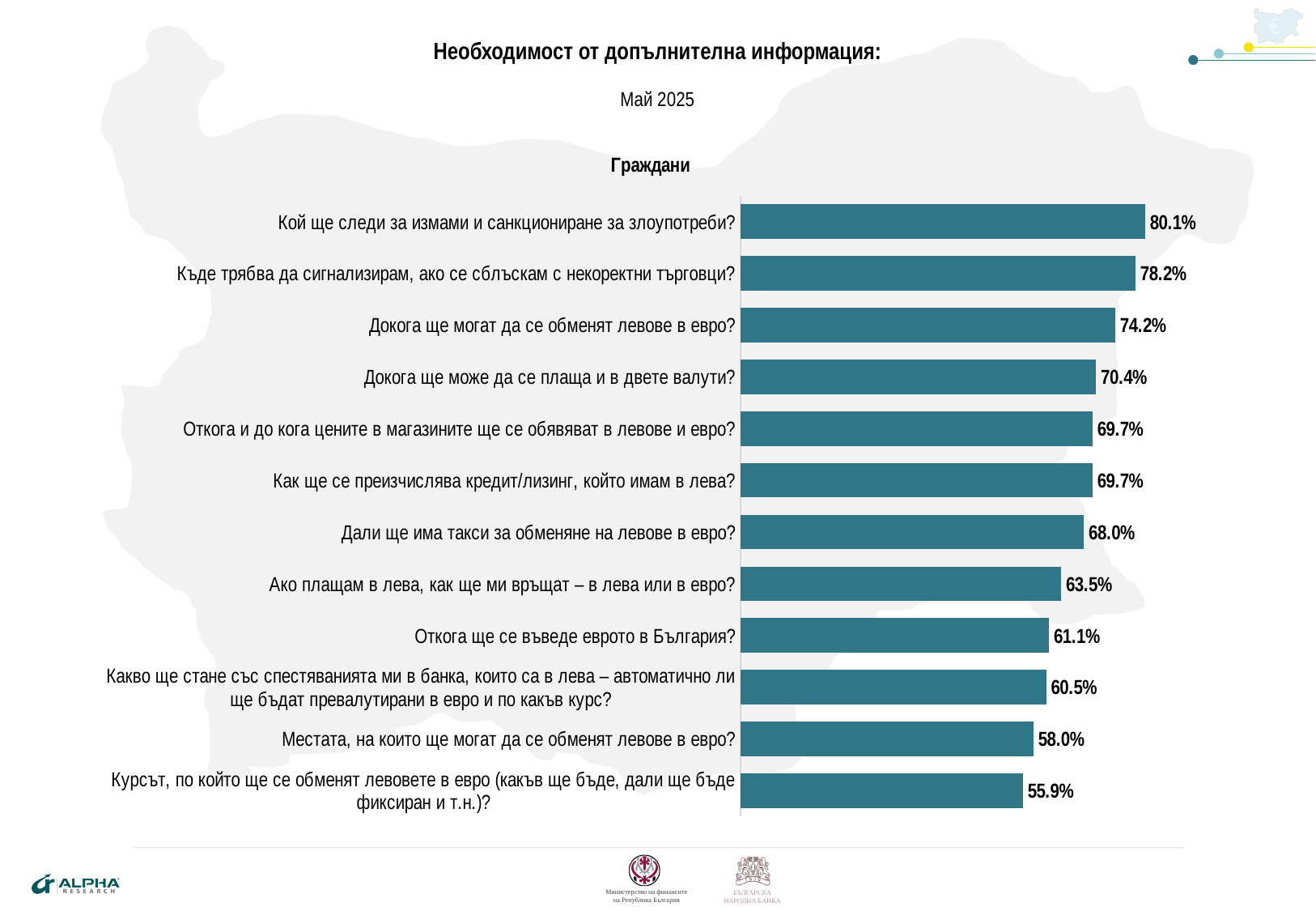
Which category has the highest value? Кой ще следи за измами и санкциониране за злоупотреби? What is the difference between the values for "Къде трябва да сигнализирам, ако се сблъскам с некоректни търговци?" and "Докога ще може да се плаща и в двете валути?"? 7.8% What is the value for "Кой ще следи за измами и санкциониране за злоупотреби?"? 80.1% How many categories are shown in the chart? 12 What is the value for "Откога ще се въведе еврото в България?"? 61.1% What is the value for "Местата, на които ще могат да се обменят левове в евро?"? 58.0% What kind of chart is shown on the slide? Bar chart Which group does the chart refer to, according to the subtitle above the bars? Граждани What is the value for "Докога ще могат да се обменят левове в евро?"? 74.2% What is the title of the chart? Граждани Which category has the lowest value? Курсът, по който ще се обменят левовете в евро (какъв ще бъде, дали ще бъде фиксиран и т.н.)? Which is larger: the value for "Дали ще има такси за обменяне на левове в евро?" or the value for "Ако плащам в лева, как ще ми връщат – в лева или в евро?"? Дали ще има такси за обменяне на левове в евро?